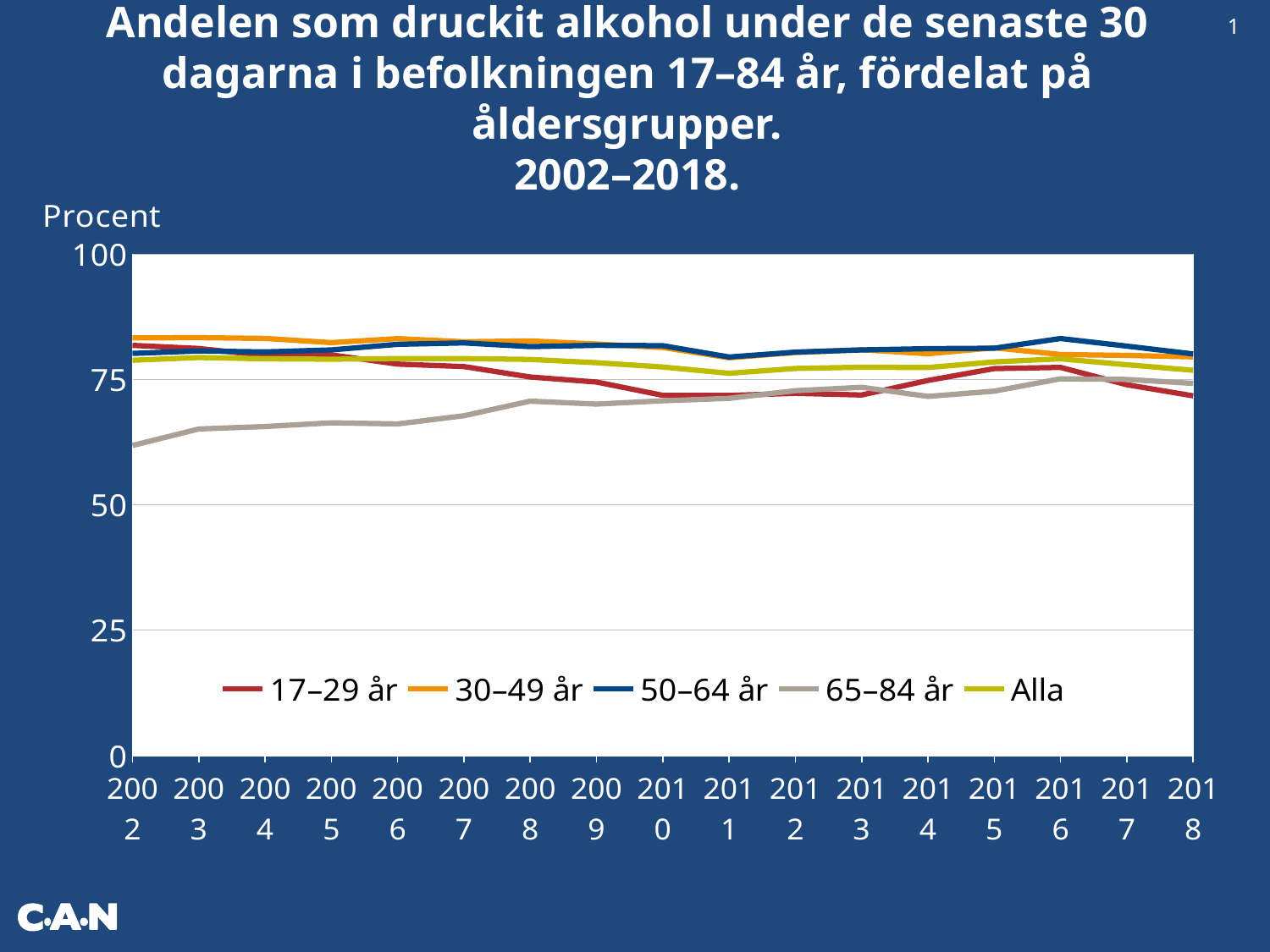
What kind of chart is shown on the slide? line chart How many series does the legend list? 5 Is the value for 50–64 år in 2016 greater or less than 75? greater Does the line for 65–84 år generally rise or fall from 2002 to 2018? rise Is the value for 65–84 år in 2002 greater or less than 75? less Which is larger in 2002, the value for 50–64 år or the value for 65–84 år? 50–64 år Which age group has the lowest value in 2002? 65–84 år Is the value for 30–49 år in 2002 greater or less than 75? greater How many years are plotted along the x axis? 17 Does the line for 17–29 år generally rise or fall from 2002 to 2018? fall What label is shown on the y axis? Procent